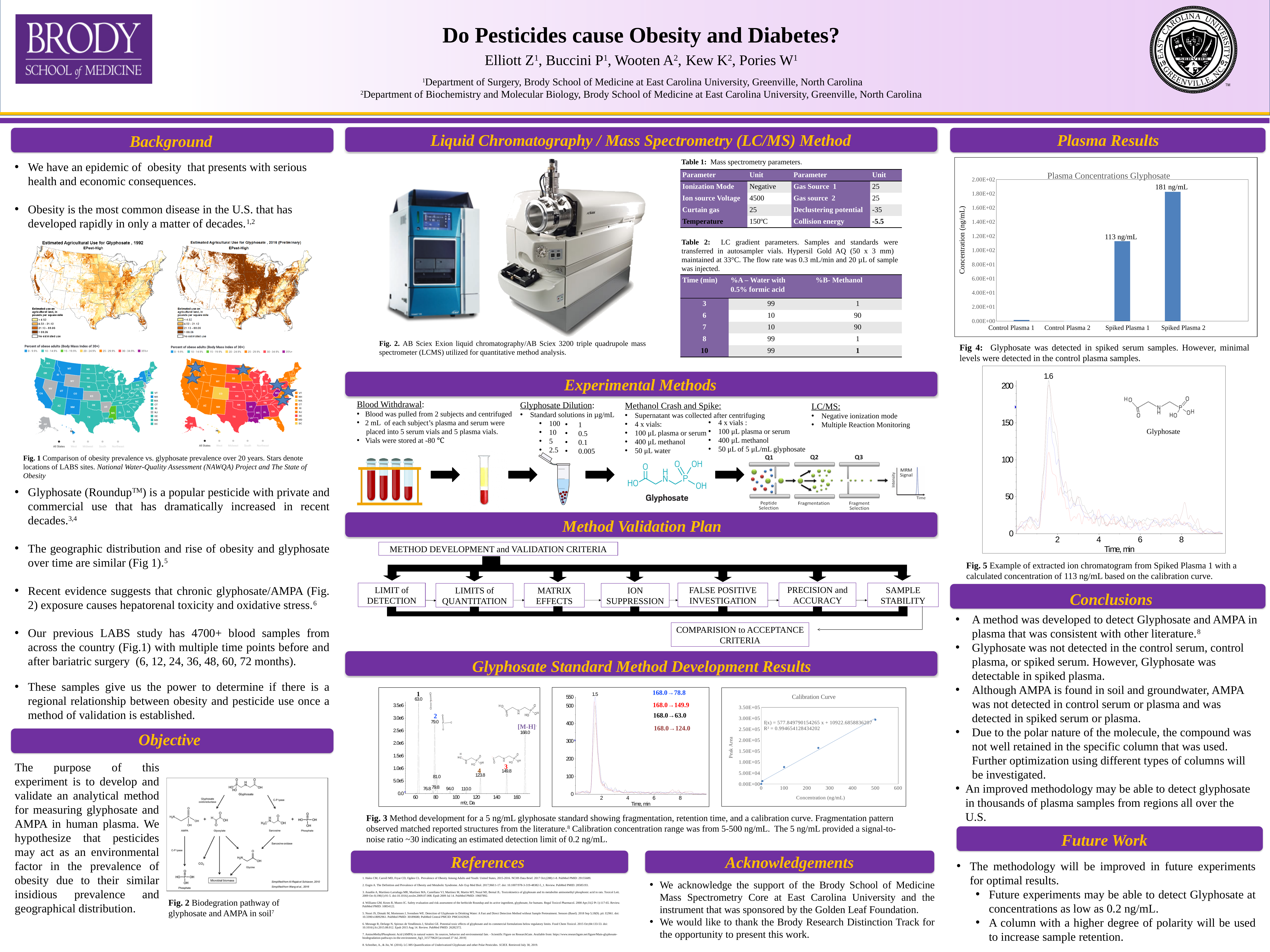
How many categories are shown on the x axis of the Plasma Concentrations Glyphosate chart? 4 In the Plasma Concentrations Glyphosate chart, what is the value for Spiked Plasma 1? 113 ng/mL In the Plasma Concentrations Glyphosate chart, which is larger, Spiked Plasma 1 or Control Plasma 1? Spiked Plasma 1 What is the x-axis label of the Calibration Curve chart? Concentration (ng/mL) In the Plasma Concentrations Glyphosate chart, what is the value for Spiked Plasma 2? 181 ng/mL What kind of chart is the Plasma Concentrations Glyphosate chart? bar chart In the Plasma Concentrations Glyphosate chart, what is the difference between Spiked Plasma 2 and Spiked Plasma 1? 68 ng/mL In the Calibration Curve chart in the Glyphosate Standard Method Development Results section, what is the R² value shown? 0.994654128434202 In the Plasma Concentrations Glyphosate chart, which category has the highest concentration? Spiked Plasma 2 What is the y-axis label of the Plasma Concentrations Glyphosate chart? Concentration (ng/mL) In the Plasma Concentrations Glyphosate chart, is the value for Control Plasma 1 greater or less than 2.00E+01? less In the Plasma Concentrations Glyphosate chart, is the value for Spiked Plasma 2 greater or less than 1.60E+02? greater